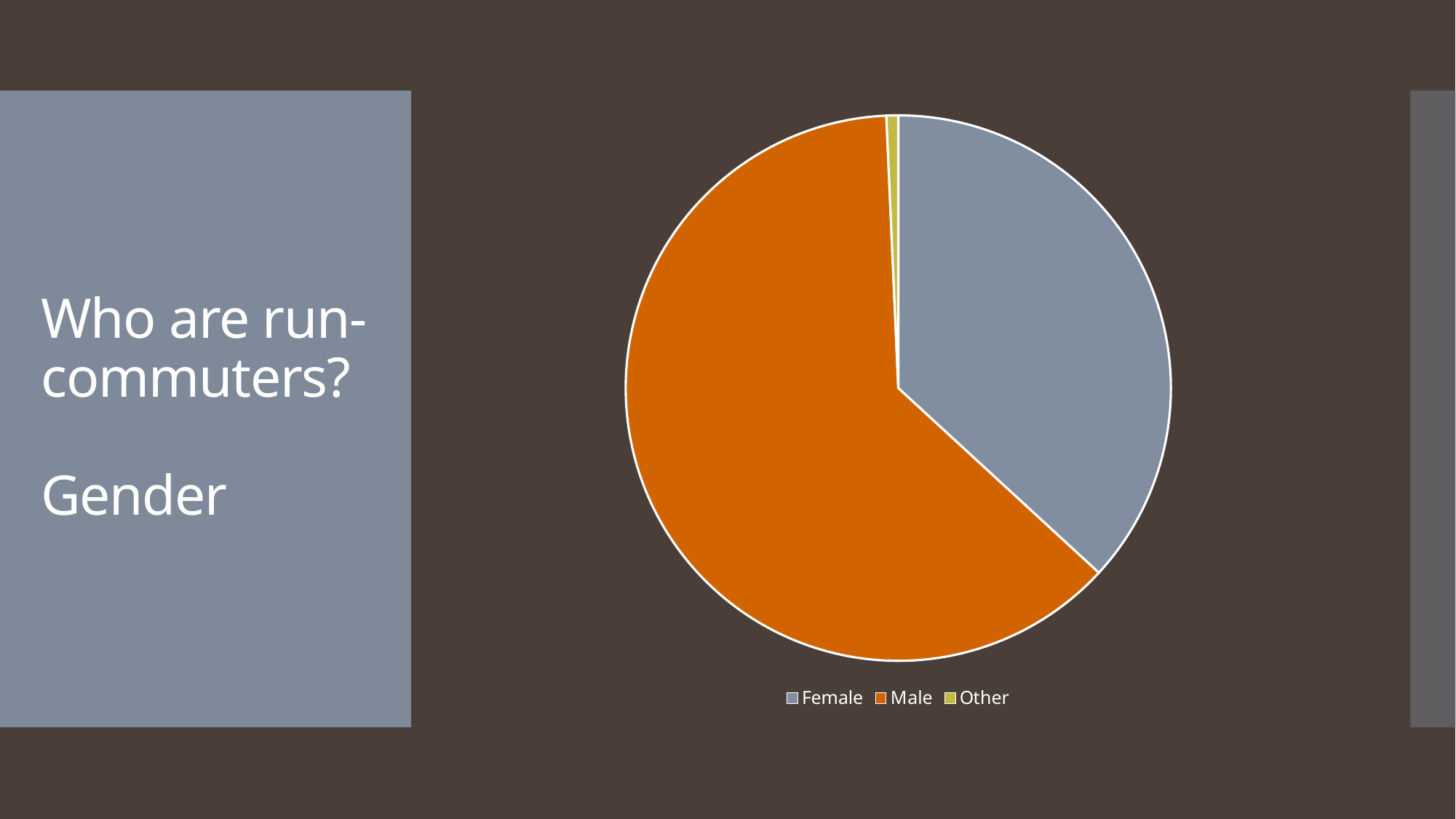
Which category has the smallest slice of the pie chart? Other What kind of chart is shown on the slide? Pie chart Which slice is smaller in the pie chart, Other or Male? Other How many slices does the pie chart have? 3 Which slice is larger in the pie chart, Female or Other? Female What are the three categories listed in the pie chart's legend? Female, Male, Other Which category has the largest slice of the pie chart? Male What colour is the Male slice in the pie chart? Orange Which slice is larger in the pie chart, Male or Female? Male How many entries does the legend of the pie chart list? 3